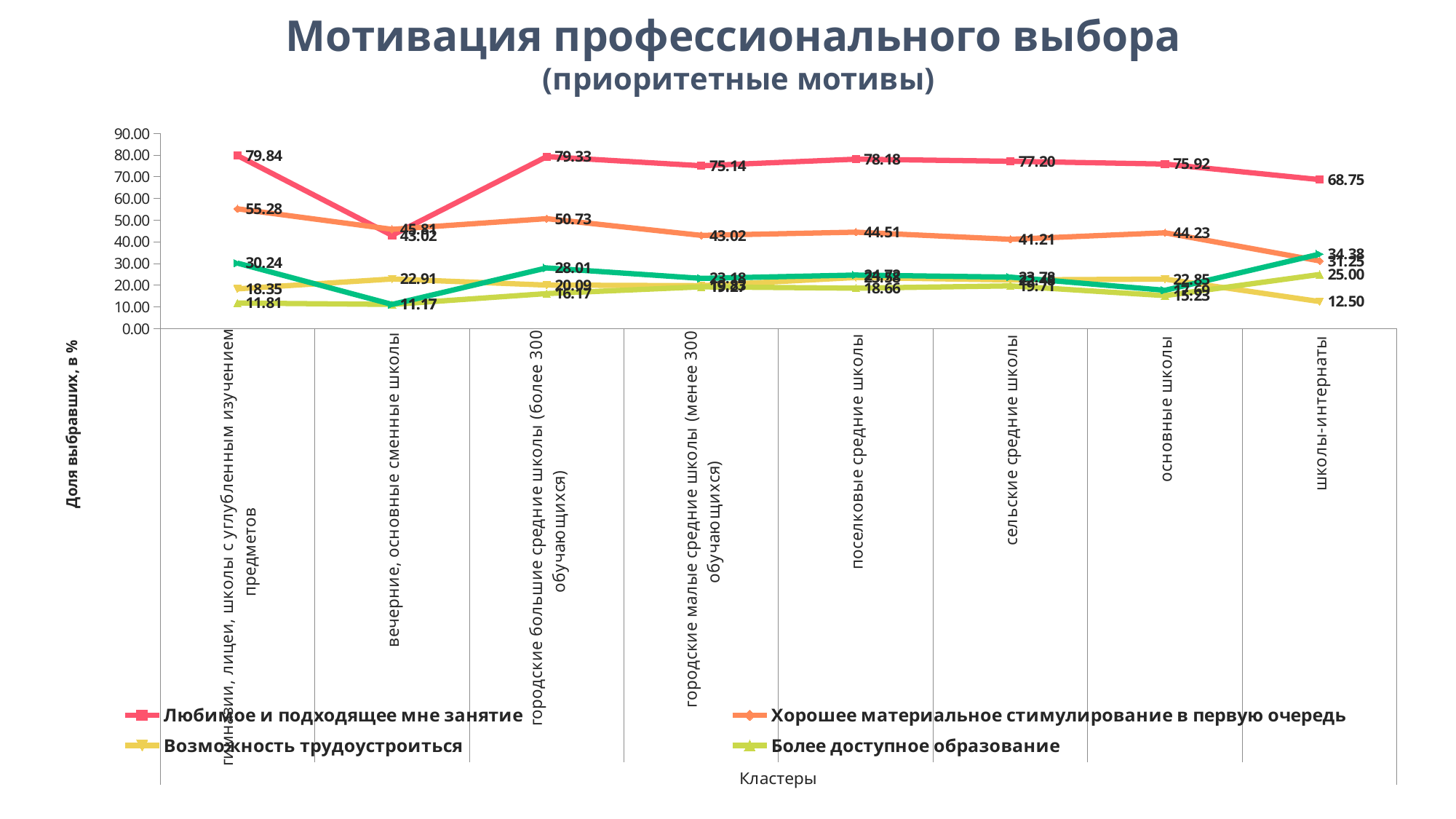
What is the value of the 'Хорошее материальное стимулирование в первую очередь' series for 'гимназии, лицеи, школы с углубленным изучением предметов'? 55.28 How many series does the legend list? 4 What is the value of the 'Любимое и подходящее мне занятие' series for 'гимназии, лицеи, школы с углубленным изучением предметов'? 79.84 What is the value of the 'Хорошее материальное стимулирование в первую очередь' series for 'школы-интернаты'? 31.25 What is the title of the vertical axis? Доля выбравших, в % What is the value of the 'Любимое и подходящее мне занятие' series for 'школы-интернаты'? 68.75 For which cluster is the 'Любимое и подходящее мне занятие' series lowest? вечерние, основные сменные школы What is the difference between the 'Любимое и подходящее мне занятие' and 'Хорошее материальное стимулирование в первую очередь' values for 'гимназии, лицеи, школы с углубленным изучением предметов'? 24.56 How many clusters are shown on the x axis? 8 What kind of chart is shown on the slide? line chart For the 'Хорошее материальное стимулирование в первую очередь' series, which is larger: 'городские большие средние школы (более 300 обучающихся)' or 'городские малые средние школы (менее 300 обучающихся)'? городские большие средние школы (более 300 обучающихся) What is the value of the 'Возможность трудоустроиться' series for 'школы-интернаты'? 12.50